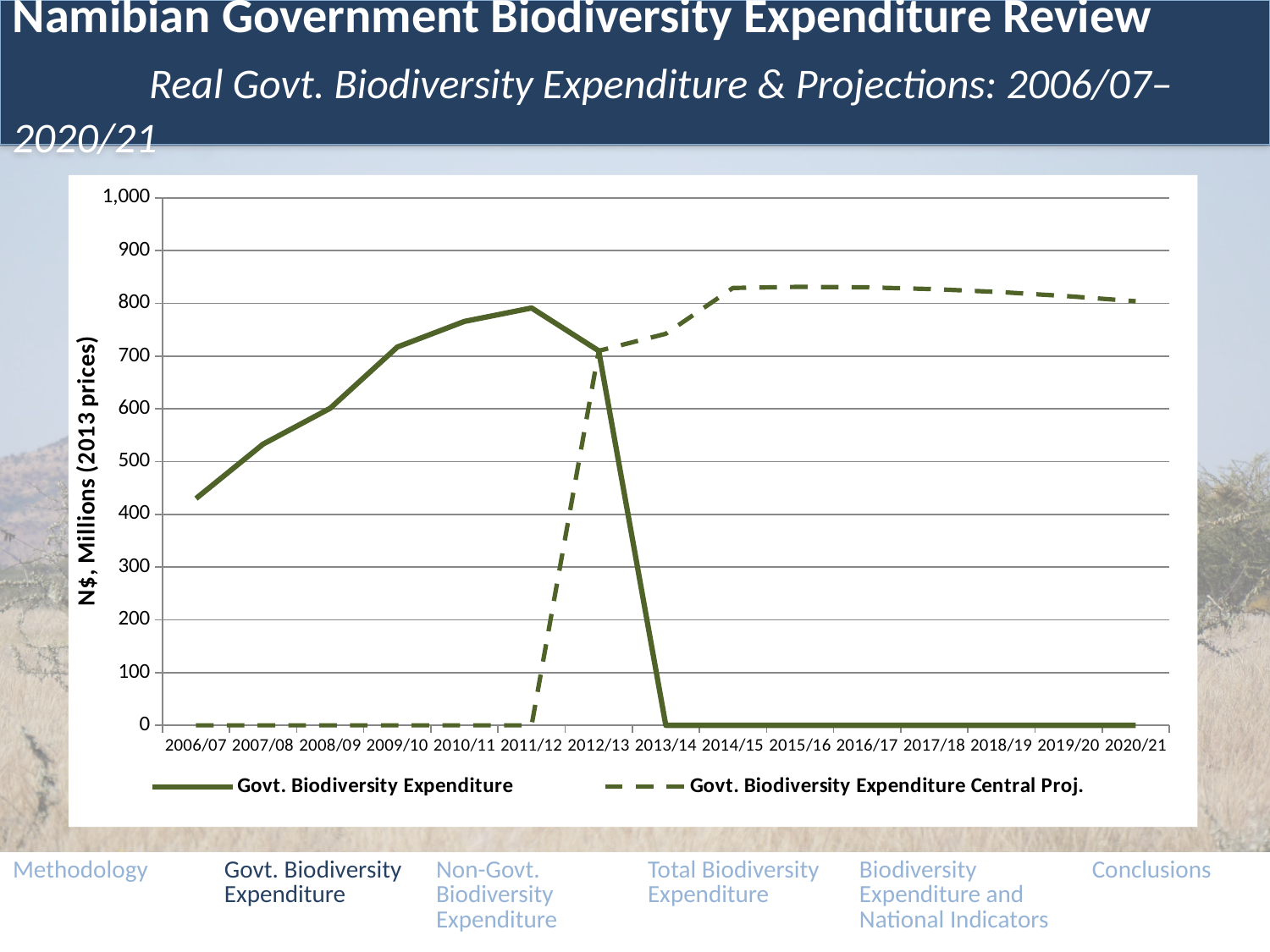
Which series is drawn with a dashed line? Govt. Biodiversity Expenditure Central Proj. How many fiscal years are shown along the x axis? 15 Which is larger for Govt. Biodiversity Expenditure: the value for 2007/08 or the value for 2009/10? 2009/10 Is the Govt. Biodiversity Expenditure value for 2006/07 greater or less than 500? less Is the Govt. Biodiversity Expenditure Central Proj. value for 2020/21 greater or less than 900? less How many series does the legend list? 2 What is the label on the y axis? N$, Millions (2013 prices) What kind of chart is shown on the slide? line chart In which year does the Govt. Biodiversity Expenditure series reach its highest value? 2011/12 Does the Govt. Biodiversity Expenditure series rise or fall from 2006/07 to 2011/12? rise Is the Govt. Biodiversity Expenditure Central Proj. value for 2014/15 greater or less than 800? greater